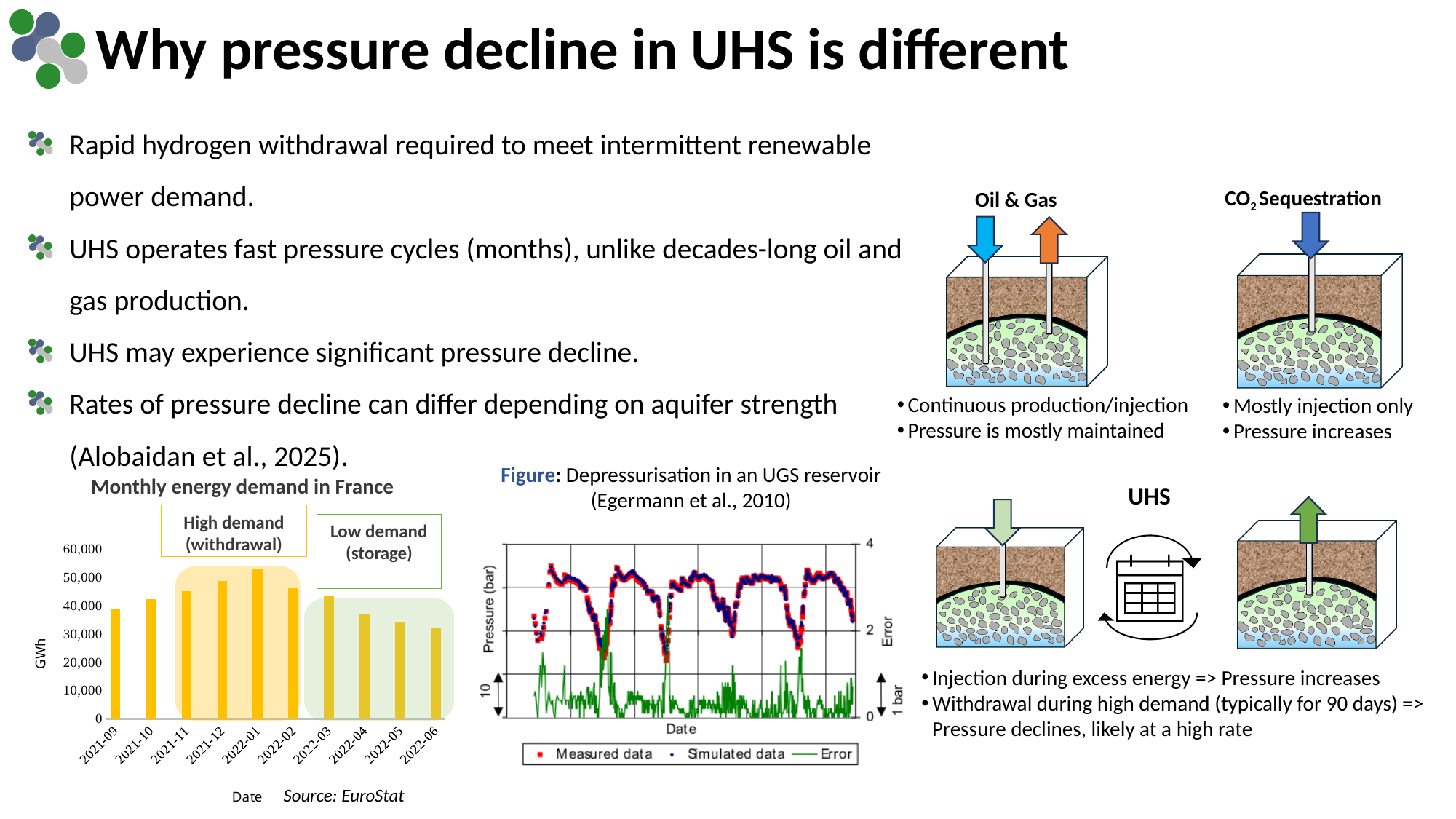
How many months are plotted in the 'Monthly energy demand in France' chart? 10 In the 'Monthly energy demand in France' chart, which is larger, the value for 2022-01 or the value for 2022-06? 2022-01 In the 'Monthly energy demand in France' chart, is the value for 2022-01 greater or less than 50,000? greater In the 'Monthly energy demand in France' chart, do the values rise or fall from 2022-01 to 2022-06? fall In the 'Monthly energy demand in France' chart, is the value for 2022-06 greater or less than 30,000? greater What kind of chart is 'Monthly energy demand in France'? bar chart In the 'Monthly energy demand in France' chart, what unit is shown on the vertical axis? GWh In the 'Monthly energy demand in France' chart, is the value for 2021-11 greater or less than 40,000? greater In the 'Monthly energy demand in France' chart, which is larger, the value for 2021-12 or the value for 2022-04? 2021-12 In the 'Monthly energy demand in France' chart, which month has the highest energy demand? 2022-01 How many series does the legend of the 'Depressurisation in an UGS reservoir' figure list? 3